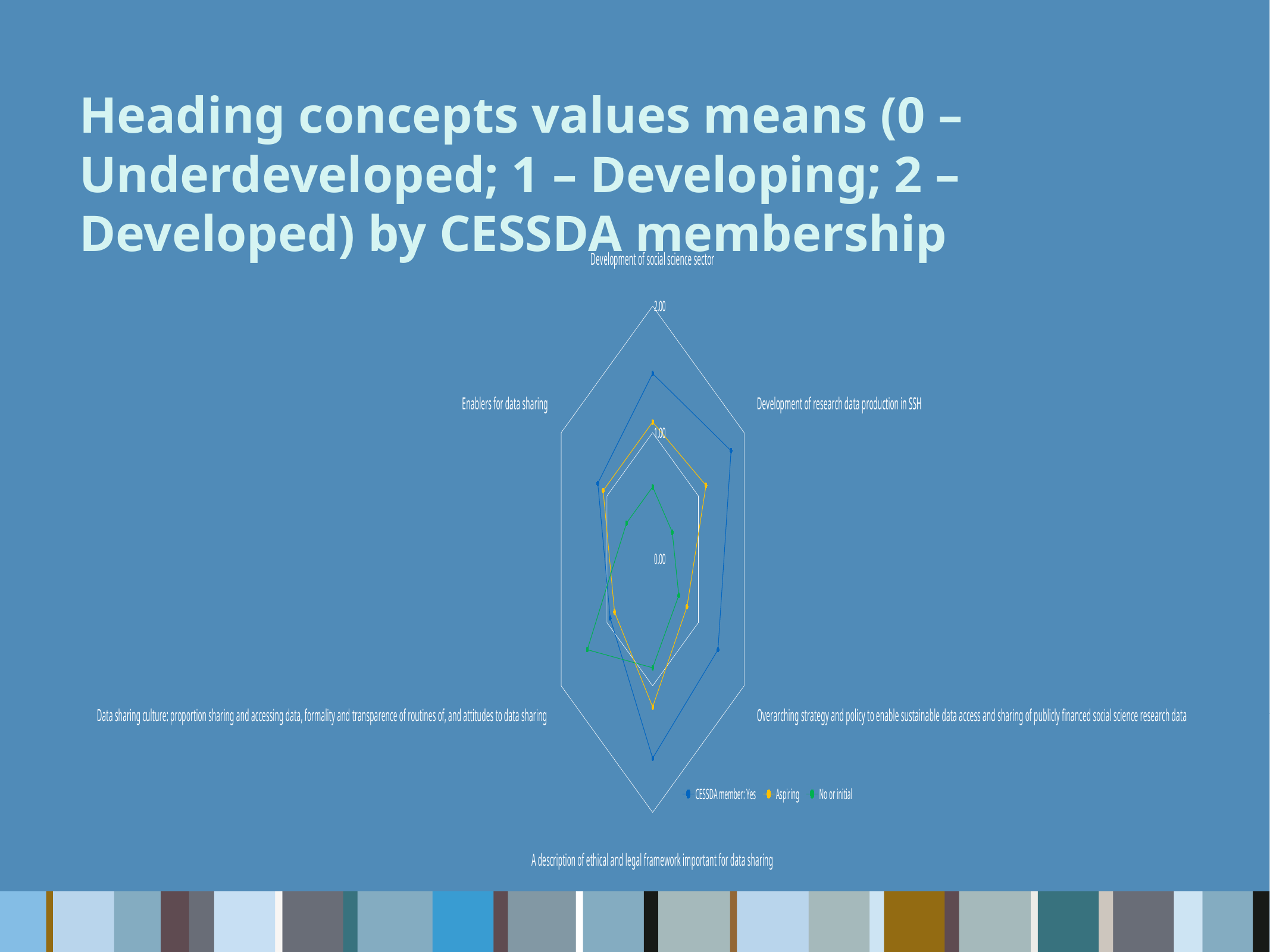
Is the value for No or initial on Data sharing culture greater or less than 1.00? greater On Data sharing culture, which series has the larger value: Aspiring or No or initial? No or initial How many categories (axes) does the radar chart have? 6 What is the highest value shown on the radar chart's axis scale? 2.00 Is the value for No or initial on Development of social science sector greater or less than 1.00? less On Development of social science sector, which series has the larger value: CESSDA member: Yes or No or initial? CESSDA member: Yes Which series has the highest value on Development of research data production in SSH? CESSDA member: Yes Is the value for CESSDA member: Yes on Development of research data production in SSH greater or less than 1.00? greater How many series does the legend list? 3 What kind of chart is shown on the slide? Radar chart